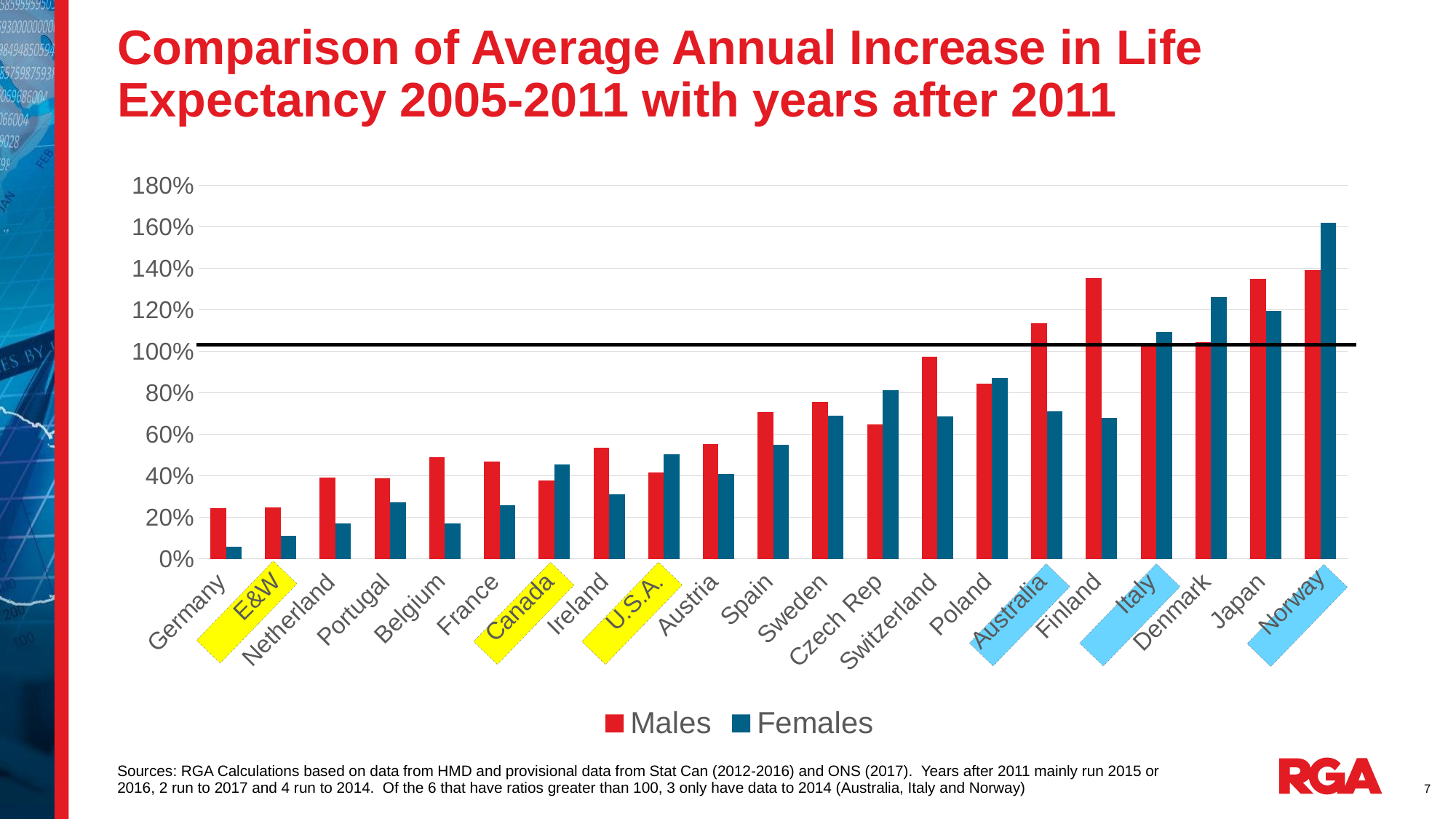
For Finland, which is larger, the Males value or the Females value? Males Do the Males values generally rise or fall from left to right along the x axis? rise For Canada, which is larger, the Males value or the Females value? Females What kind of chart is shown on the slide? bar chart Which country has the lowest Females value? Germany Is the Females value for Norway greater or less than 140%? greater How many series does the legend list? 2 How many countries are shown on the x axis? 21 Is the Females value for Australia greater or less than 80%? less Is the Females value for Germany greater or less than 20%? less Which country has the highest Females value? Norway